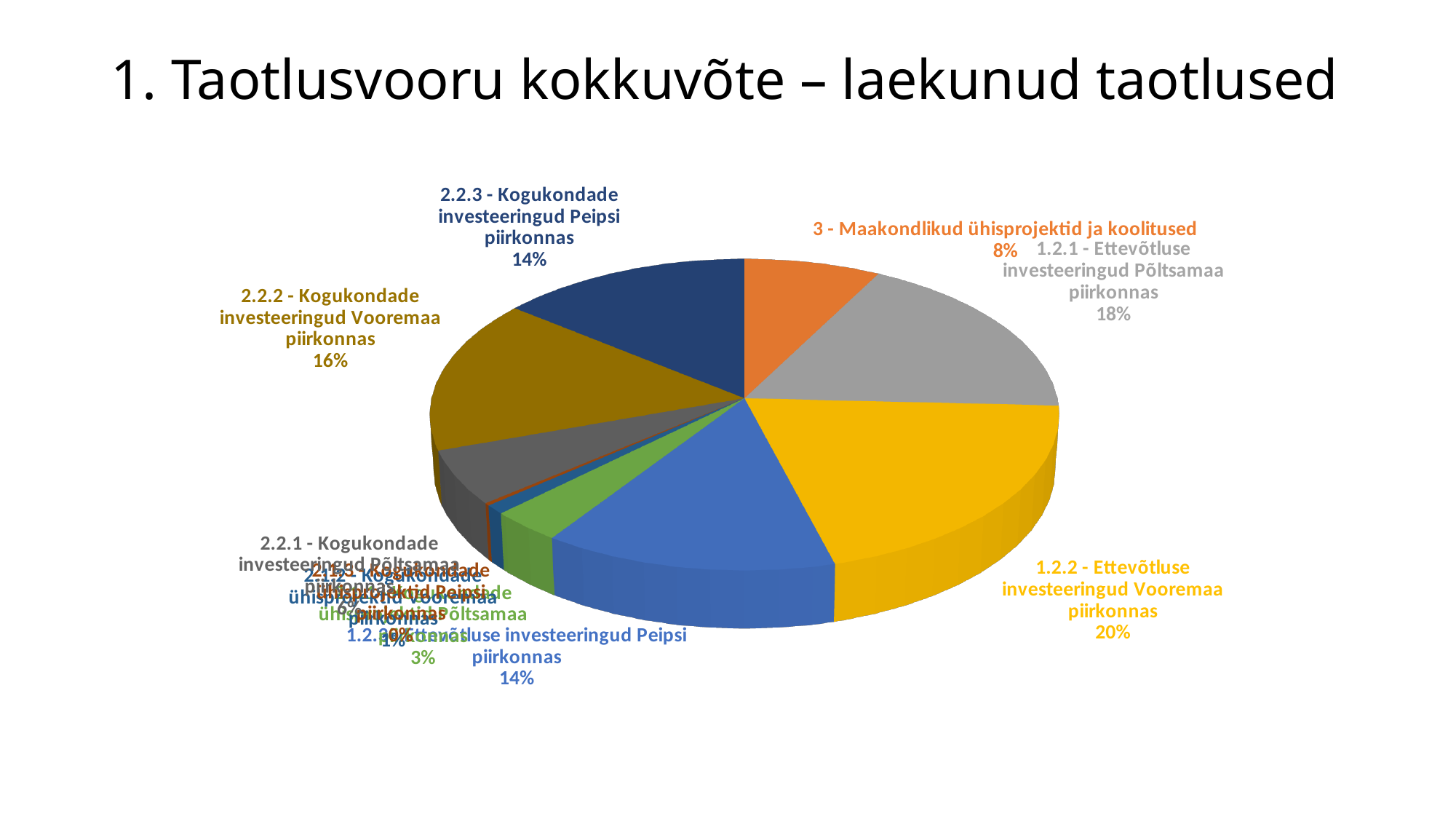
What share of the pie does '1.2.2 - Ettevõtluse investeeringud Vooremaa piirkonnas' have? 20% What share of the pie does '1.2.3 - Ettevõtluse investeeringud Peipsi piirkonnas' have? 14% What is the title of the slide? 1. Taotlusvooru kokkuvõte – laekunud taotlused Which category has the largest share of the pie? 1.2.2 - Ettevõtluse investeeringud Vooremaa piirkonnas What share of the pie does '3 - Maakondlikud ühisprojektid ja koolitused' have? 8% What colour is the slice for '1.2.2 - Ettevõtluse investeeringud Vooremaa piirkonnas'? yellow What is the difference in percentage points between '1.2.2 - Ettevõtluse investeeringud Vooremaa piirkonnas' and '2.2.2 - Kogukondade investeeringud Vooremaa piirkonnas'? 4 percentage points Which has a larger share: '1.2.1 - Ettevõtluse investeeringud Põltsamaa piirkonnas' or '3 - Maakondlikud ühisprojektid ja koolitused'? 1.2.1 - Ettevõtluse investeeringud Põltsamaa piirkonnas What kind of chart is shown on the slide? pie chart